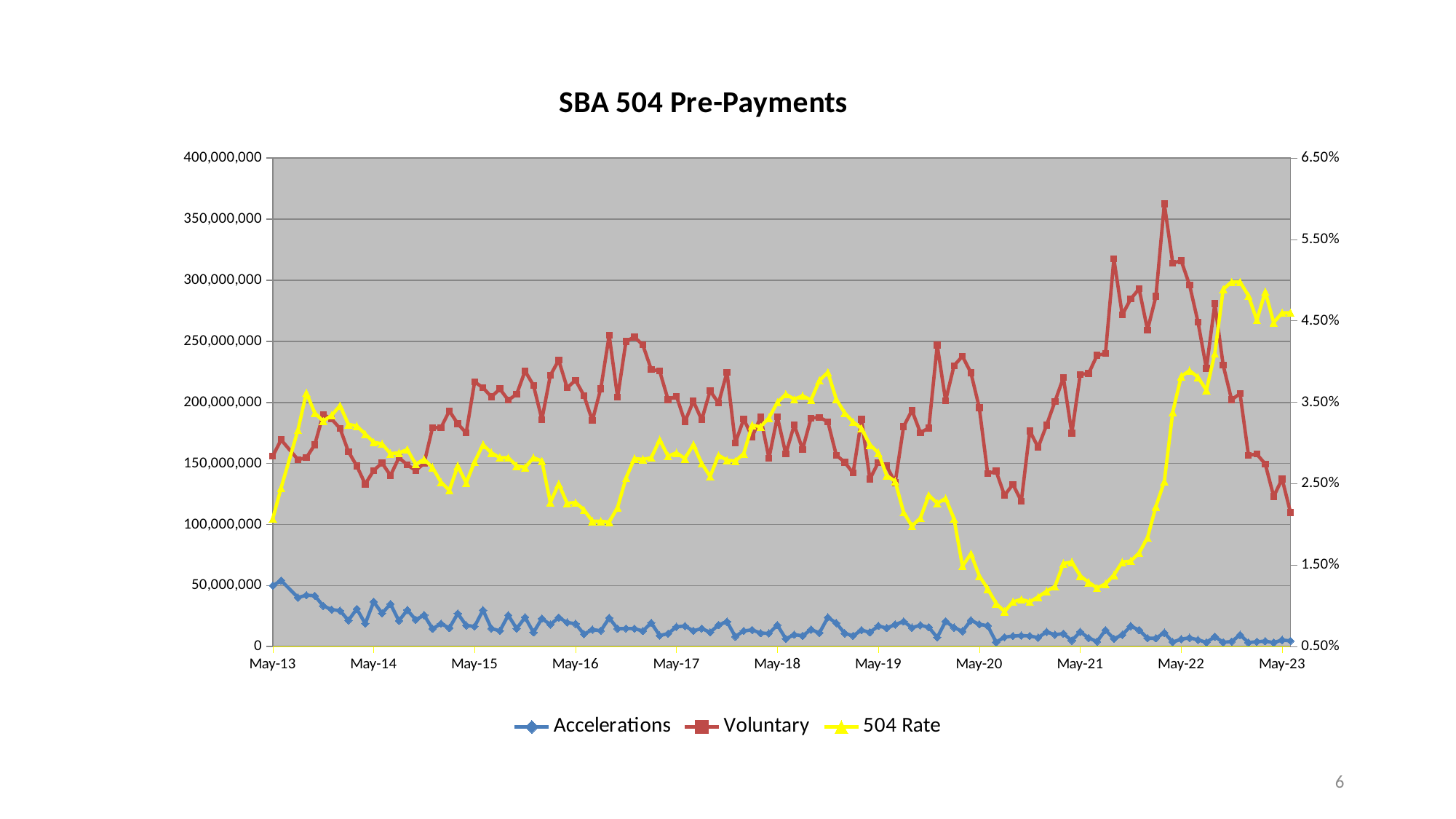
What is the title of the chart? SBA 504 Pre-Payments Is the value for Accelerations at May-23 greater or less than 50,000,000? less What kind of chart is shown on the slide? Line chart Which series is shown in yellow in the legend? 504 Rate How many labelled tick marks are on the x axis? 11 Does the Accelerations series generally rise or fall from May-13 to May-23? Fall At May-18, which series has the larger value on the left axis, Voluntary or Accelerations? Voluntary How many series does the legend list? 3 Is the value for Accelerations at May-13 greater or less than 100,000,000? less Is the peak value of the Voluntary series greater or less than 300,000,000? greater